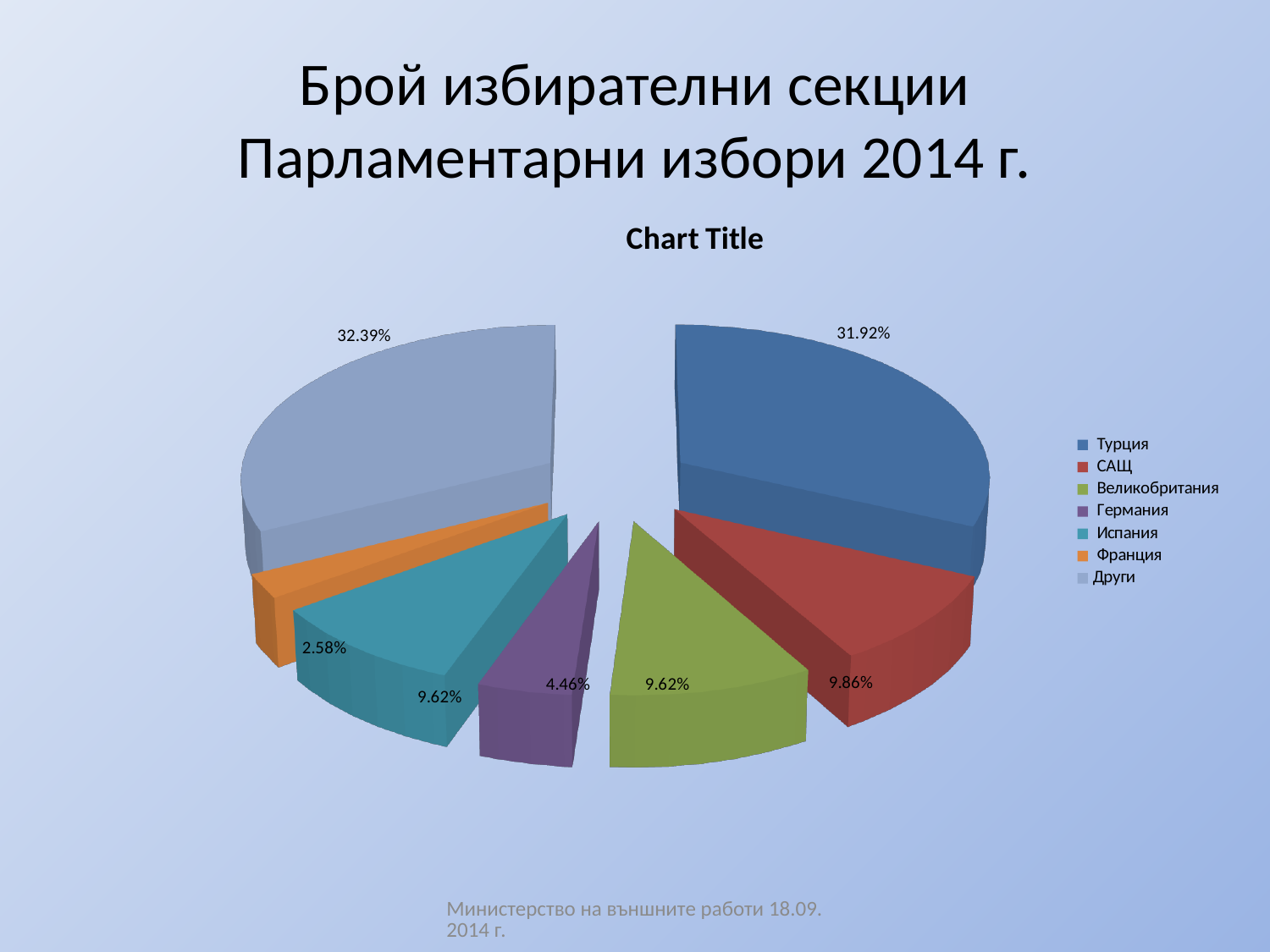
What share of the pie does Германия have? 4.46% What is the title printed above the pie chart? Chart Title What share of the pie does Франция have? 2.58% How many categories does the legend list? 7 What share of the pie does Турция have? 31.92% What is the difference between the shares of Други and Турция? 0.47% What type of chart is shown on the slide? pie chart Which category has the largest share of the pie? Други Which category has the smallest share of the pie? Франция Which has a larger share, САЩ or Германия? САЩ What share of the pie does Други have? 32.39% What share of the pie does САЩ have? 9.86%